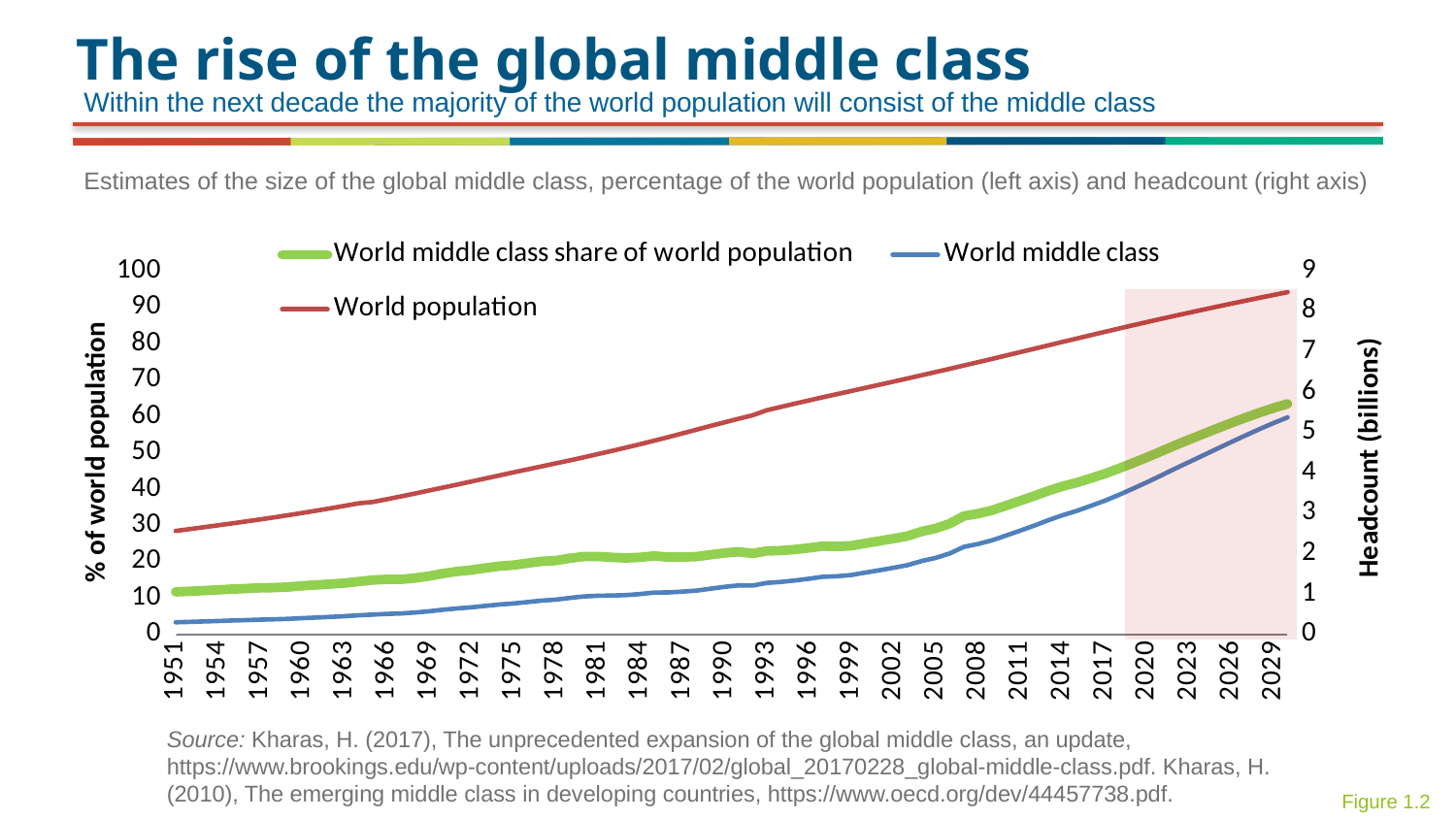
Is the World middle class share of world population in 1951 greater or less than 20 on the left axis? less Which series in the legend is drawn in green? World middle class share of world population What kind of chart is shown on the slide? Line chart Is the World middle class share of world population in 2029 greater or less than 50 on the left axis? greater Is the World population value in 2029 greater or less than 8 on the right axis? greater What is the label of the right-hand vertical axis? Headcount (billions) How many series does the chart's legend list? 3 Does the World middle class share of world population line rise or fall over the period shown? Rises Does the World population line rise or fall from 1951 to 2029? Rises In 2029, which is larger on the right axis: World population or World middle class? World population